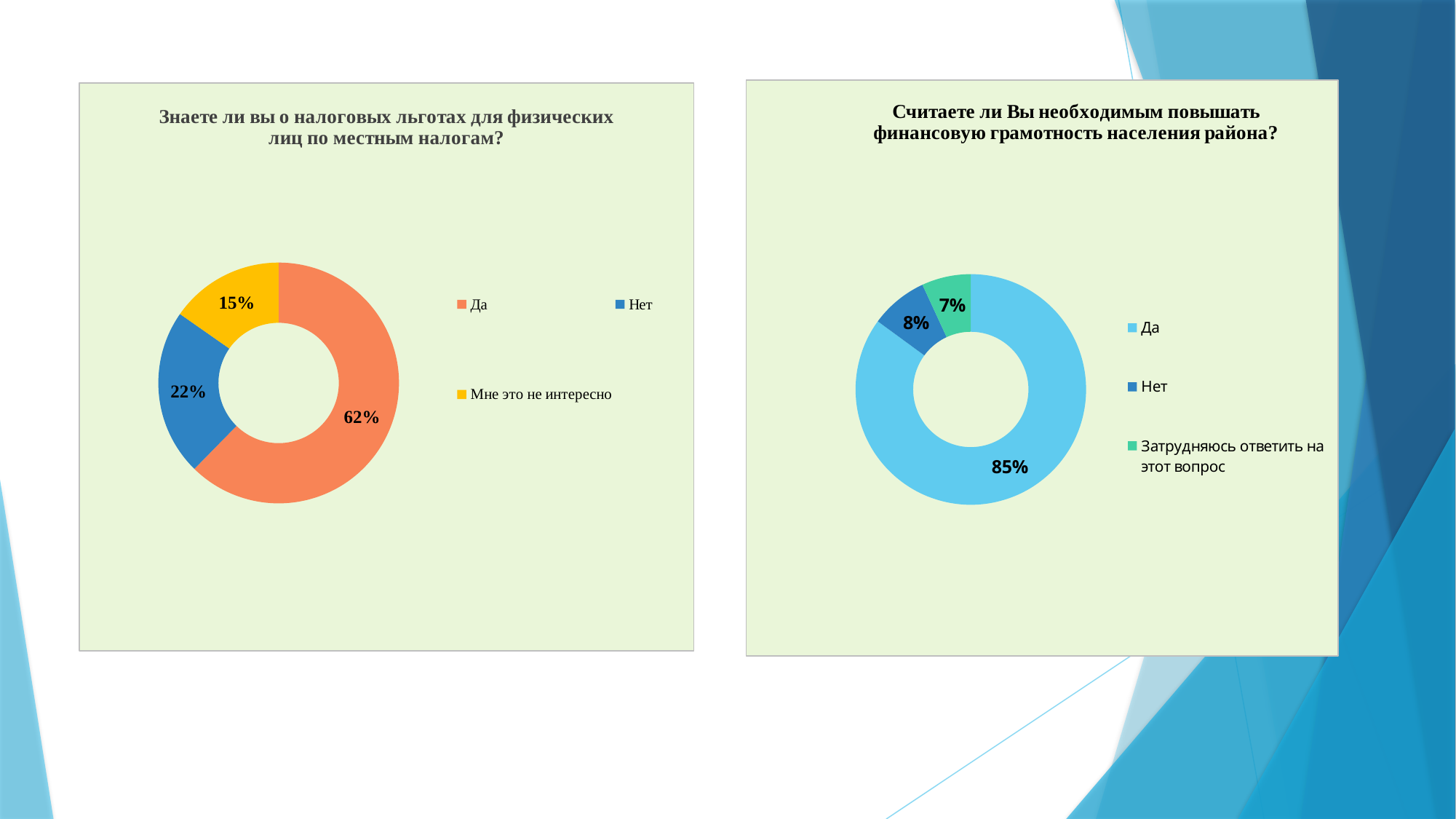
In the right chart, what share of respondents answered "Затрудняюсь ответить на этот вопрос"? 7% In the left chart, which answer has the smallest share? Мне это не интересно In the left chart, what share of respondents answered "Мне это не интересно"? 15% What type of chart is the right chart? Doughnut (pie) chart In the left chart, what share of respondents answered "Нет"? 22% In the right chart, which answer has the largest share? Да In the right chart (Считаете ли Вы необходимым повышать финансовую грамотность населения района?), what share of respondents answered "Да"? 85% In the left chart (Знаете ли вы о налоговых льготах для физических лиц по местным налогам?), what share of respondents answered "Да"? 62% In the right chart, what share of respondents answered "Нет"? 8% In the left chart, how many categories are shown? 3 In the left chart, what colour is the "Нет" segment? Blue In the left chart, what is the difference between the shares for "Да" and "Нет"? 40%